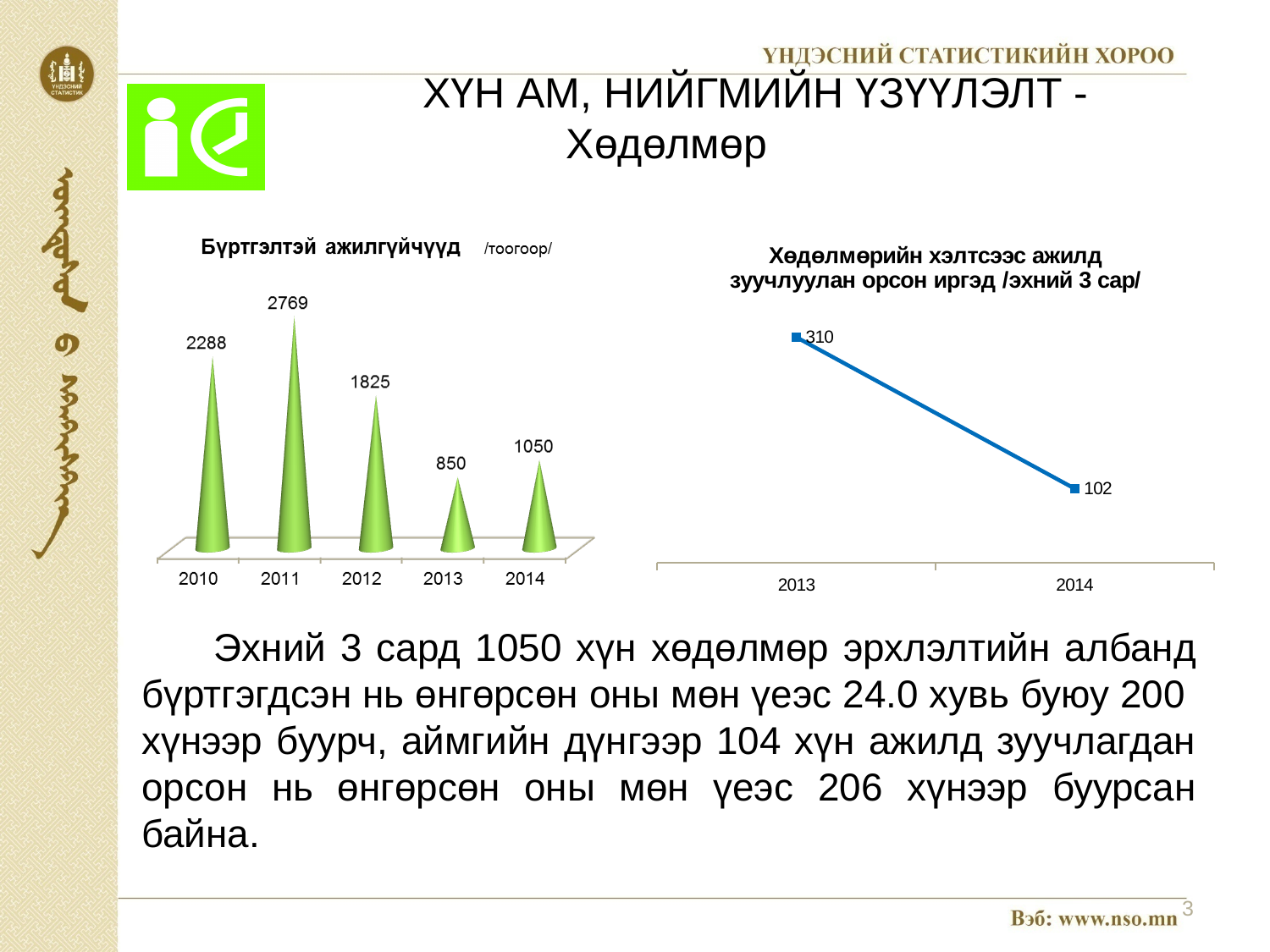
In the right chart (Хөдөлмөрийн хэлтсээс ажилд зуучлуулан орсон иргэд), what is the difference between the 2013 and 2014 values? 208 What kind of chart is the left chart (Бүртгэлтэй ажилгүйчүүд)? Bar chart In the left chart (Бүртгэлтэй ажилгүйчүүд), what is the value for 2013? 850 In the left chart (Бүртгэлтэй ажилгүйчүүд), which is larger, the value for 2013 or the value for 2014? 2014 In the left chart (Бүртгэлтэй ажилгүйчүүд), what is the difference between the values for 2010 and 2012? 463 In the left chart (Бүртгэлтэй ажилгүйчүүд), what is the value for 2011? 2769 In the right chart (Хөдөлмөрийн хэлтсээс ажилд зуучлуулан орсон иргэд), does the value rise or fall from 2013 to 2014? Fall In the left chart (Бүртгэлтэй ажилгүйчүүд), which year has the lowest value? 2013 In the left chart (Бүртгэлтэй ажилгүйчүүд), which year has the highest value? 2011 In the right chart (Хөдөлмөрийн хэлтсээс ажилд зуучлуулан орсон иргэд), what is the value for 2013? 310 In the right chart (Хөдөлмөрийн хэлтсээс ажилд зуучлуулан орсон иргэд), what is the value for 2014? 102 How many years are shown in the left chart (Бүртгэлтэй ажилгүйчүүд)? 5